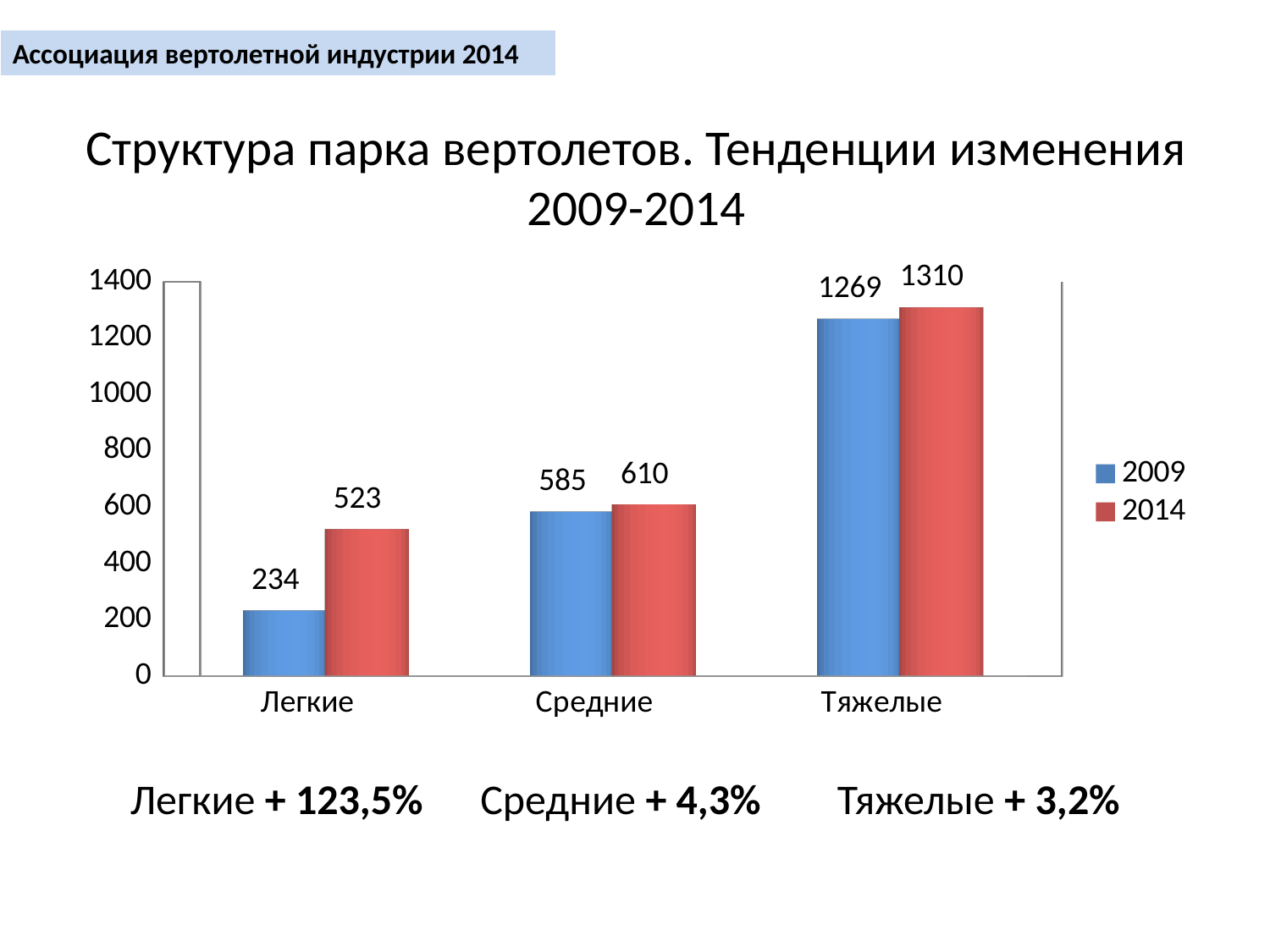
What is the value for Средние in 2014? 610 Which category has the lowest value in the 2009 series? Легкие Which is larger: the 2009 value for Средние or the 2014 value for Легкие? 2009 value for Средние How many categories are shown on the x axis? 3 What kind of chart is shown on the slide? Bar chart How many series does the legend list? 2 What is the value for Тяжелые in 2014? 1310 Which colour represents the 2014 series in the legend? Red What is the difference between the 2014 and 2009 values for Легкие? 289 What is the difference between the 2014 and 2009 values for Тяжелые? 41 What is the value for Легкие in 2009? 234 Which category has the highest value in the 2014 series? Тяжелые